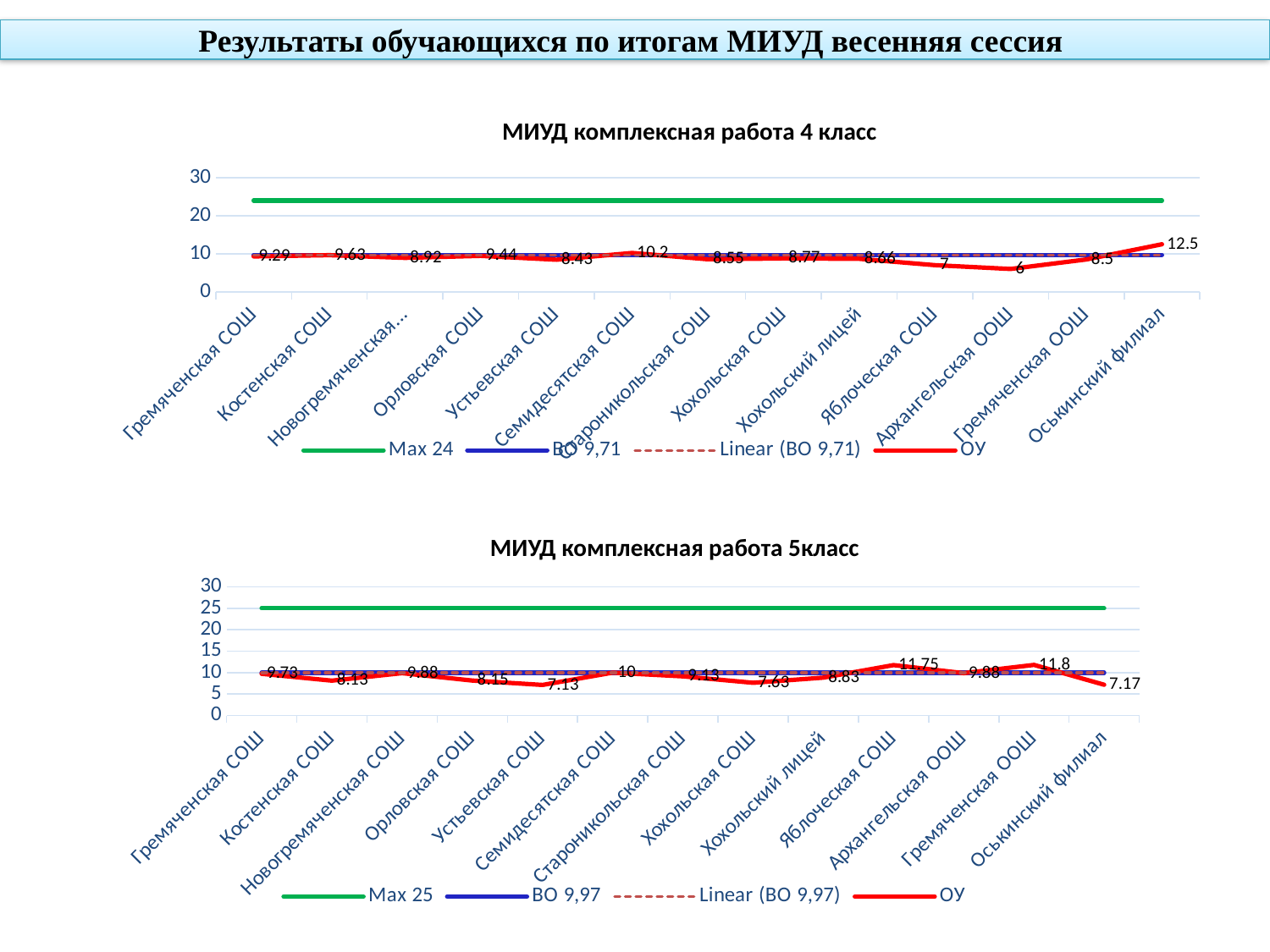
How many schools are shown on the x axis of the 'МИУД комплексная работа 5класс' chart? 13 In the 'МИУД комплексная работа 4 класс' chart, what is the ОУ value for Оськинский филиал? 12.5 What is the title of the bottom chart on the slide? МИУД комплексная работа 5класс In the 'МИУД комплексная работа 5класс' chart, which is larger: the ОУ value for Гремяченская ООШ or for Устьевская СОШ? Гремяченская ООШ In the 'МИУД комплексная работа 4 класс' chart, which school has the highest ОУ value? Оськинский филиал In the 'МИУД комплексная работа 4 класс' chart, which school has the lowest ОУ value? Архангельская ООШ How many series does the legend of the 'МИУД комплексная работа 4 класс' chart list? 4 What kind of chart is the 'МИУД комплексная работа 4 класс' chart? line chart In the 'МИУД комплексная работа 5класс' chart, what is the ОУ value for Оськинский филиал? 7.17 In the 'МИУД комплексная работа 4 класс' chart, what is the difference between the ОУ values for Оськинский филиал and Архангельская ООШ? 6.5 In the 'МИУД комплексная работа 4 класс' chart, is the Max 24 line greater or less than 20? greater In the 'МИУД комплексная работа 4 класс' chart, what is the ОУ value for Архангельская ООШ? 6